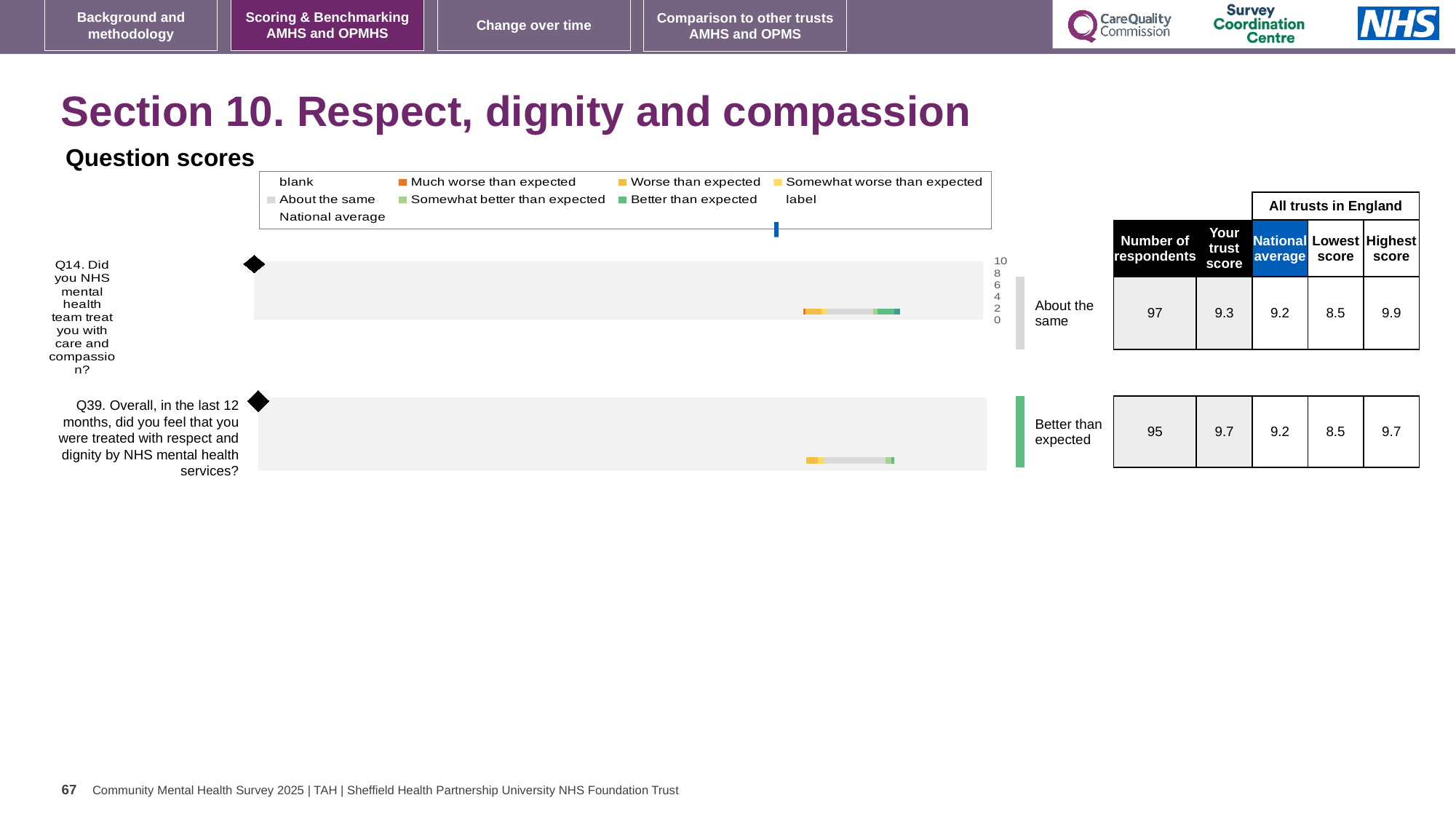
What is the trust score for Q14 (care and compassion)? 9.3 What benchmark category is shown next to the Q39 chart? Better than expected What colour does the legend use for 'Much worse than expected'? Orange What is the trust score for Q39 (respect and dignity)? 9.7 What is the highest score among all trusts in England for Q14? 9.9 What kind of chart is used to show the question scores? Bar chart How many respondents answered Q39? 95 What is the national average for Q14? 9.2 What is the difference between the Q39 trust score and the Q39 national average? 0.5 How many question charts are shown on the slide? 2 Which question has the higher trust score, Q14 or Q39? Q39 What benchmark category is shown next to the Q14 chart? About the same